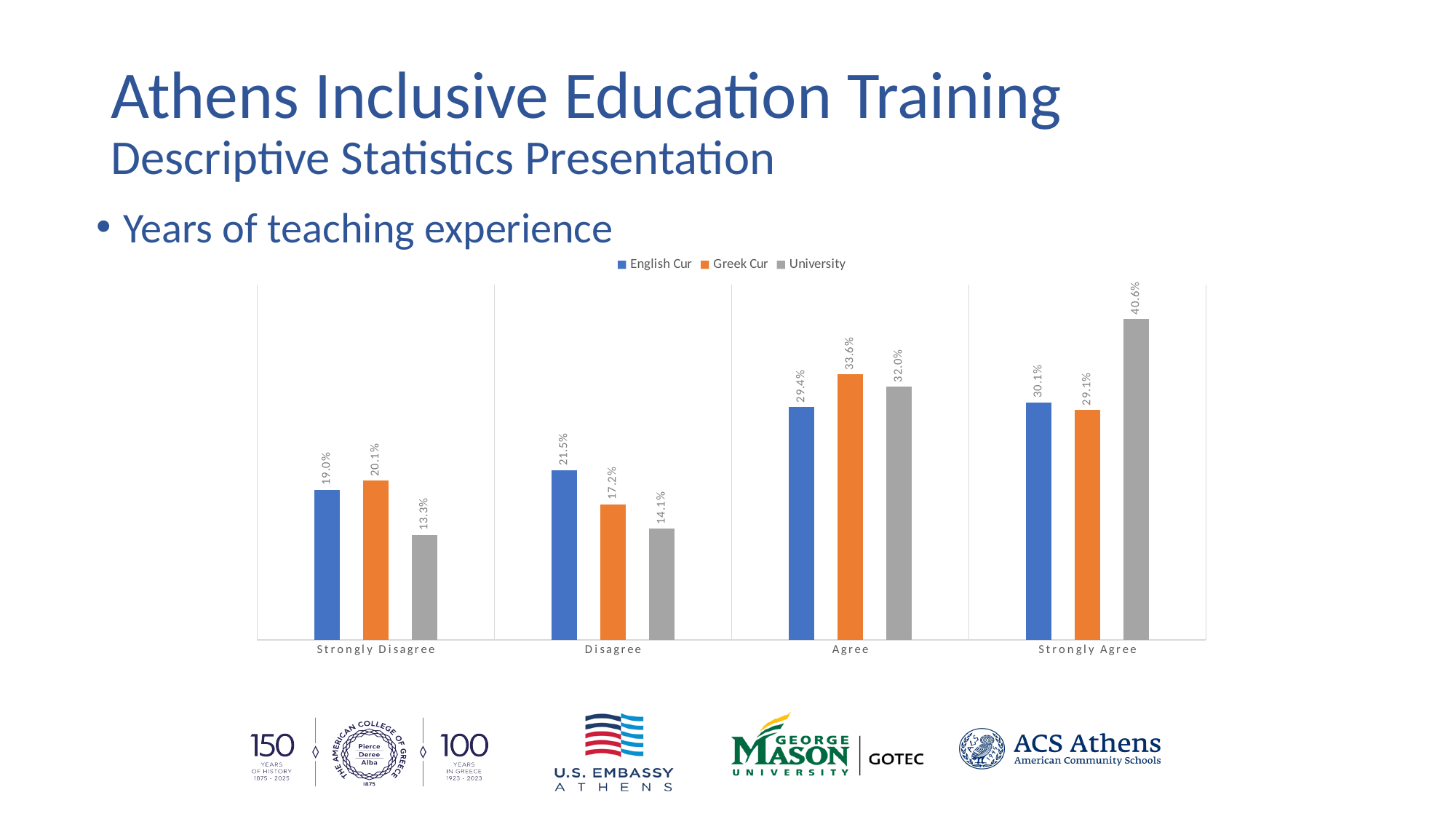
What is the difference between the University and English Cur values in the Strongly Agree category? 10.5% How many series does the legend list? 3 Which category has the highest value for University? Strongly Agree How many categories are shown on the x axis? 4 What is the value for English Cur in the Disagree category? 21.5% What is the value for University in the Strongly Disagree category? 13.3% What is the value for University in the Strongly Agree category? 40.6% What is the value for Greek Cur in the Agree category? 33.6% What kind of chart is shown on the slide? Bar chart Which is larger in the Disagree category, English Cur or Greek Cur? English Cur Which category has the lowest value for Greek Cur? Disagree Which series is shown in orange in the legend? Greek Cur